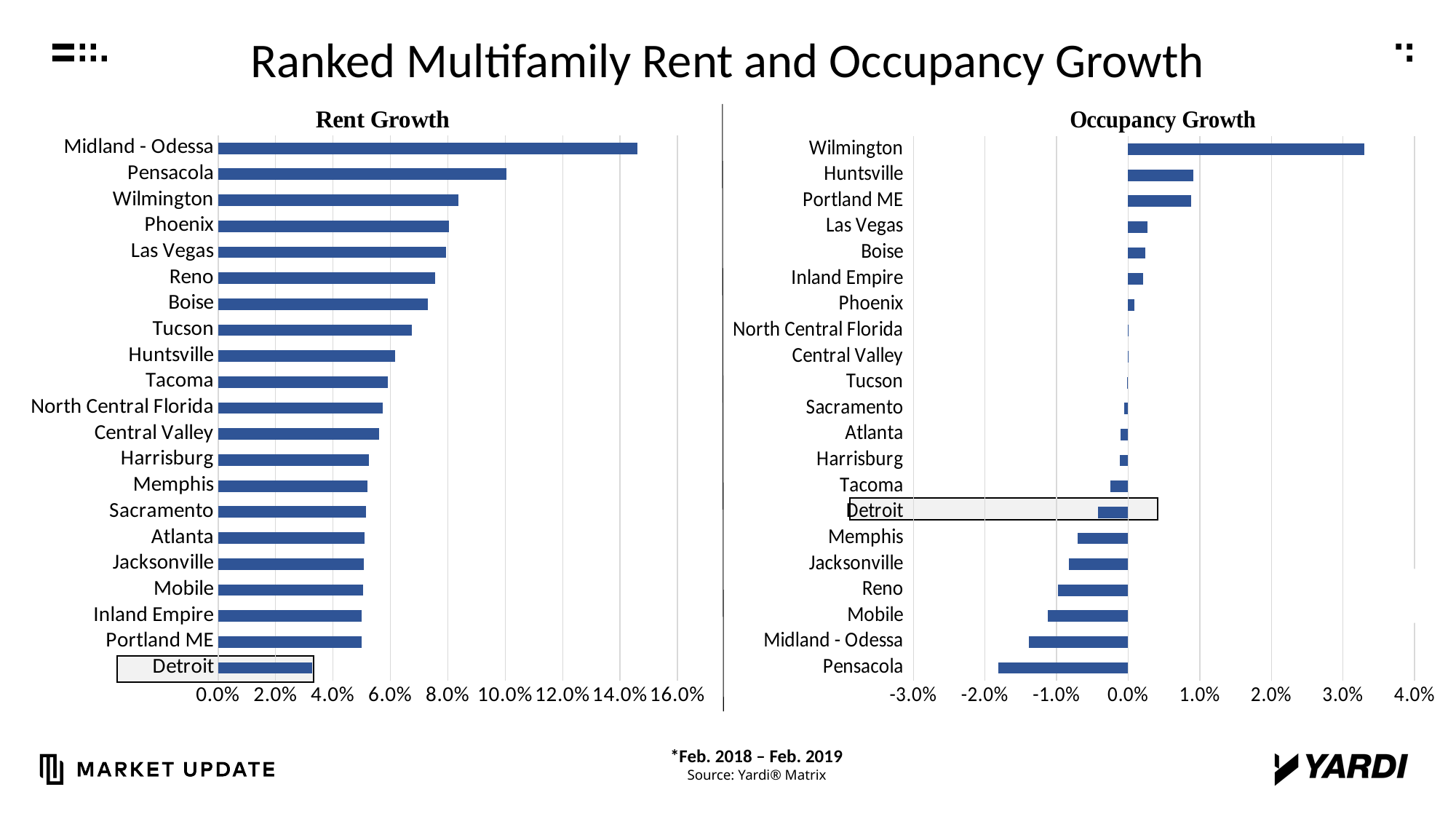
Which market is highlighted with a box in both charts? Detroit In the Occupancy Growth chart, which market has the lowest occupancy growth? Pensacola In the Occupancy Growth chart, which market has the highest occupancy growth? Wilmington In the Rent Growth chart, which has higher rent growth, Pensacola or Wilmington? Pensacola What kind of chart is the Rent Growth chart? bar chart In the Rent Growth chart, is the value for Midland - Odessa greater or less than 14.0%? greater In the Occupancy Growth chart, is the value for Pensacola greater or less than -1.0%? less In the Rent Growth chart, is the value for Detroit greater or less than 4.0%? less In the Rent Growth chart, which market has the highest rent growth? Midland - Odessa How many markets are shown in the Rent Growth chart? 21 In the Rent Growth chart, which market has the lowest rent growth? Detroit